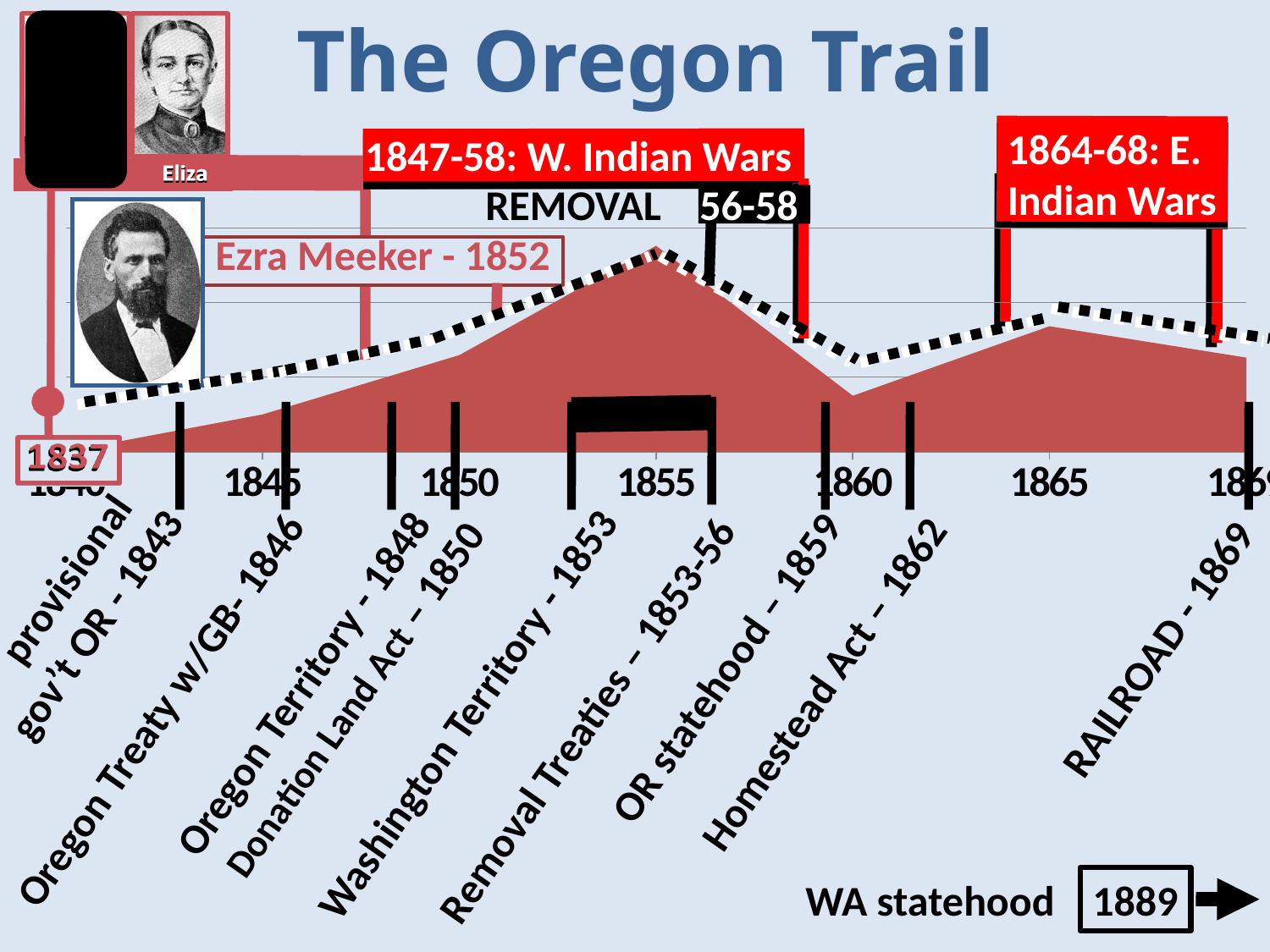
What is the last year label on the x axis? 1869 Near which x-axis year label does the red shaded area reach its highest point? 1855 How many year labels are printed along the x axis? 7 What is the first year label on the x axis? 1840 Does the red shaded area rise or fall along the x axis from 1840 to 1855? rise What kind of chart is shown on the slide? area chart What year is shown in the box next to 'WA statehood' at the bottom right? 1889 What is the title of the slide? The Oregon Trail Does the dotted line rise or fall along the x axis from 1860 to 1865? rise Is the red shaded area higher at 1855 or at 1865? 1855 Does the red shaded area rise or fall along the x axis from 1855 to 1860? fall Near which x-axis year label does the red shaded area reach its lowest point between 1855 and 1865? 1860